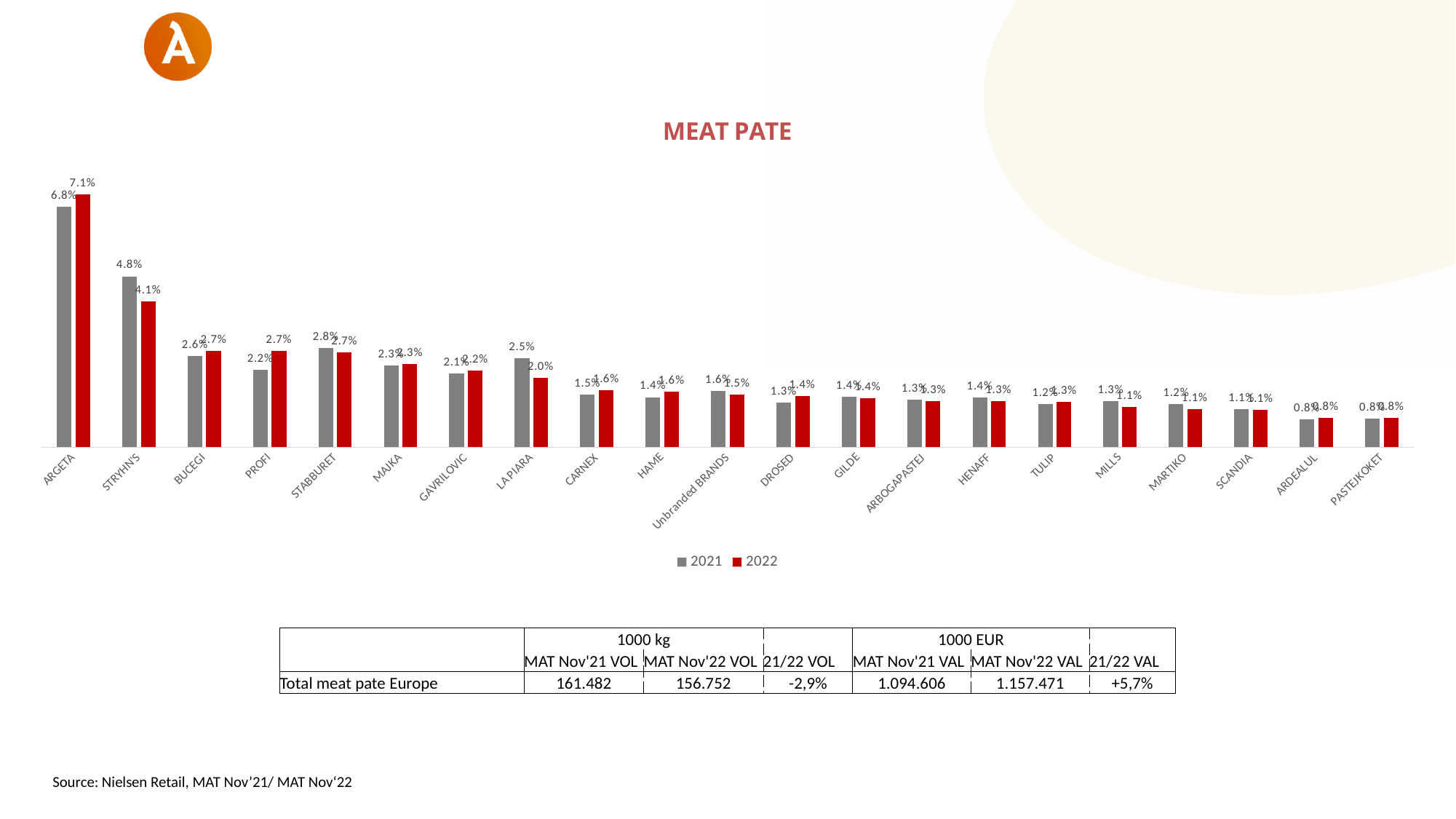
What is the 2021 value for LA PIARA? 2.5% How many series does the legend list? 2 Which is larger for PROFI, the 2021 value or the 2022 value? 2022 What is the 2021 value for STRYHN'S? 4.8% How many brands are shown on the x axis of the chart? 21 Which brand has the highest 2022 value? ARGETA What is the difference between ARGETA's 2022 value and its 2021 value? 0.3% What is the 2022 value for PROFI? 2.7% What is the 2022 value for ARGETA? 7.1% Which is larger for LA PIARA, the 2021 value or the 2022 value? 2021 What is the difference between the 2021 and 2022 values for STRYHN'S? 0.7% What type of chart is shown on the slide? Bar chart